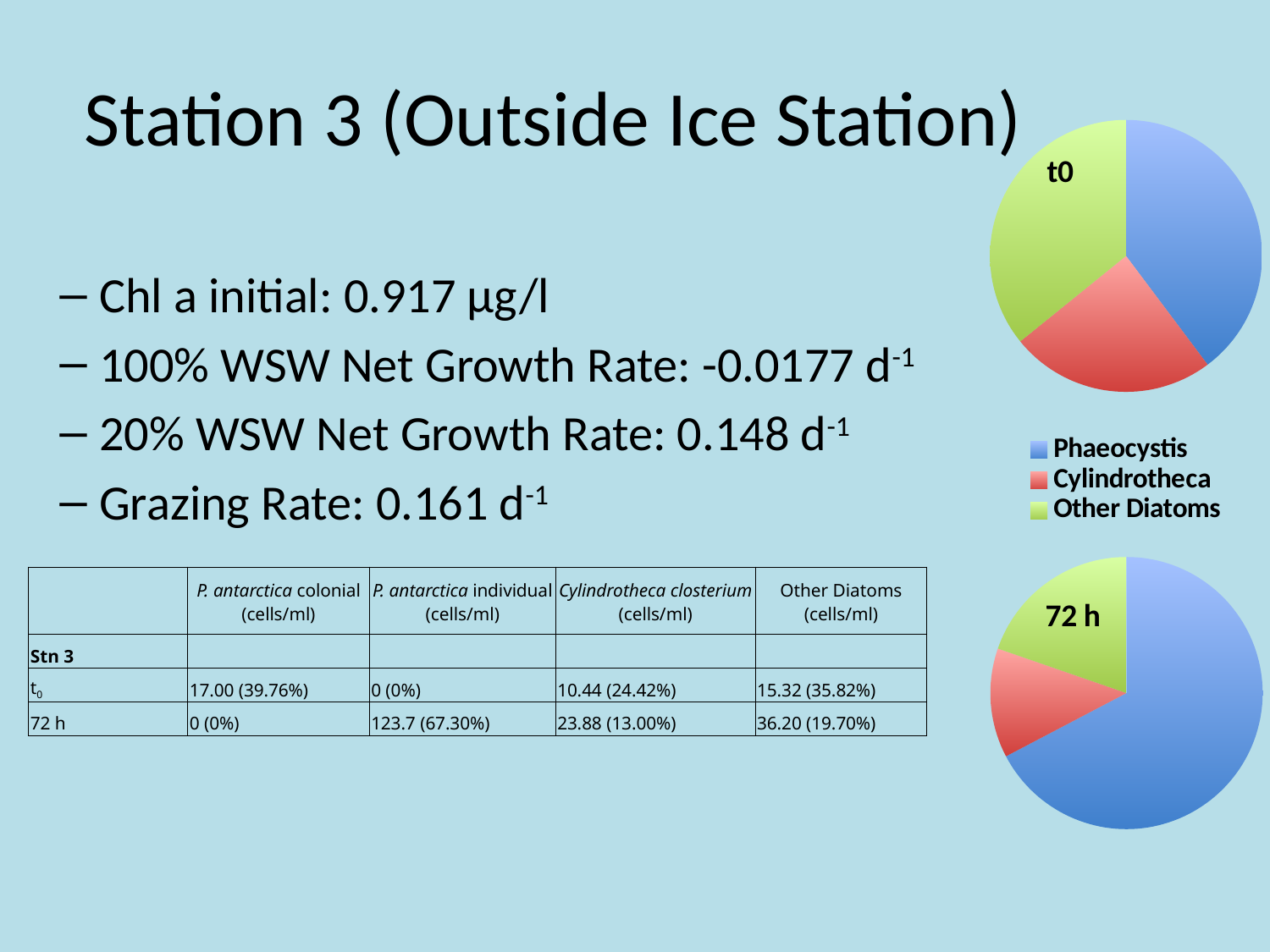
In the t0 pie chart, how many slices are there? 3 In the t0 pie chart, which category has the smallest slice? Cylindrotheca What kind of chart is the chart labelled 72 h? pie chart What colour represents Phaeocystis in the pie charts? blue In the 72 h pie chart, which category has the smallest slice? Cylindrotheca In the 72 h pie chart, which category has the largest slice? Phaeocystis What kind of chart is the chart labelled t0? pie chart In the 72 h pie chart, which slice is larger, Phaeocystis or Other Diatoms? Phaeocystis What are the labels of the two pie charts on the slide? t0 and 72 h In the t0 pie chart, which slice is larger, Phaeocystis or Cylindrotheca? Phaeocystis How many entries does the legend shared by the pie charts list? 3 In the 72 h pie chart, which slice is larger, Other Diatoms or Cylindrotheca? Other Diatoms